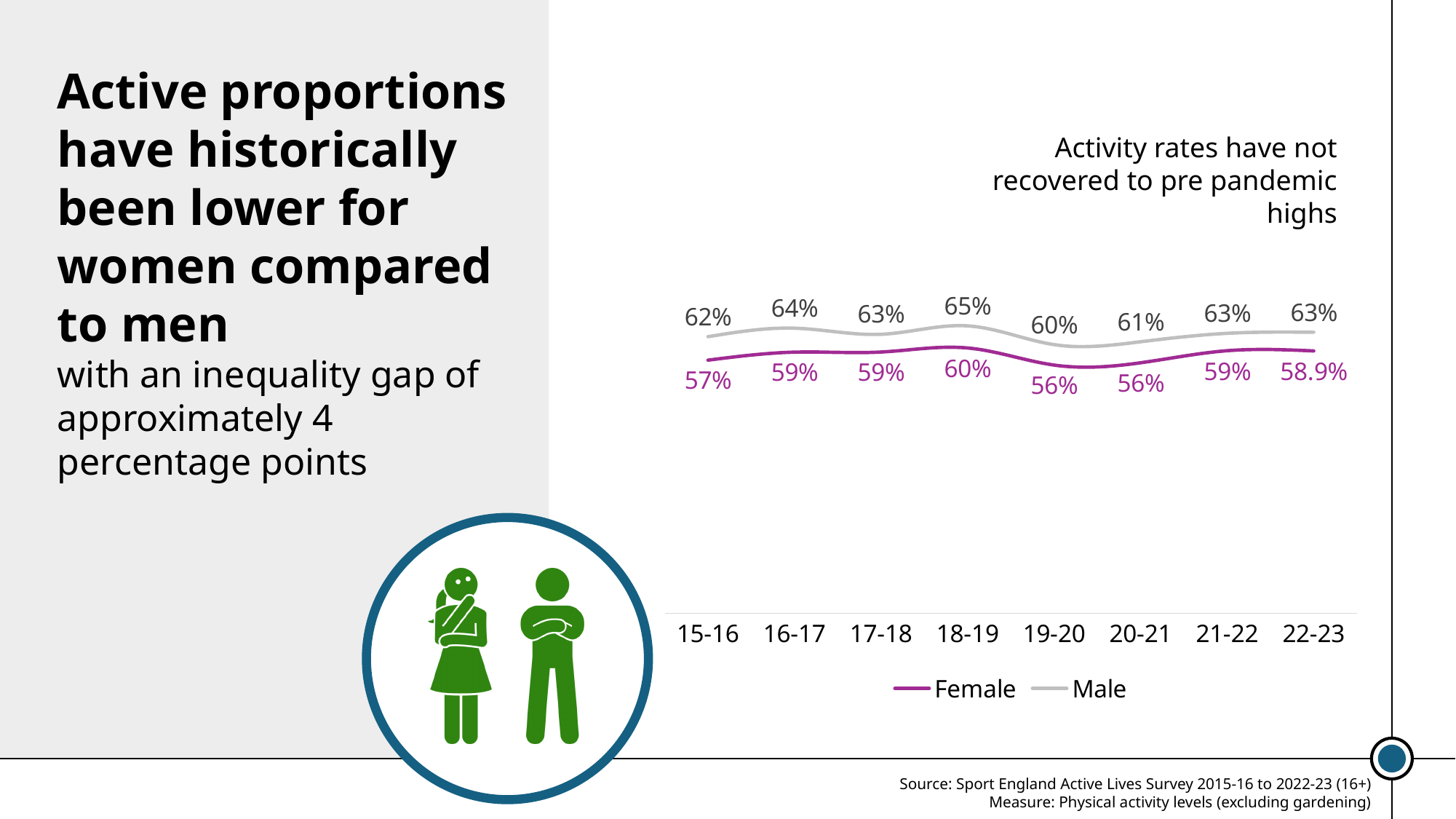
What is the Female value for 22-23? 58.9% How many years are shown on the x axis? 8 In which year does the Male series reach its highest value? 18-19 What is the difference between the Male values for 18-19 and 19-20? 5 percentage points What is the Female value for 15-16? 57% In which year is the Male series at its lowest value? 19-20 Which series has the higher value in 20-21, Female or Male? Male What colour is the Female line in the chart? Purple What is the difference between the Male and Female values in 18-19? 5 percentage points How many series does the legend list? 2 What kind of chart is shown on the slide? Line chart What is the Male value for 18-19? 65%